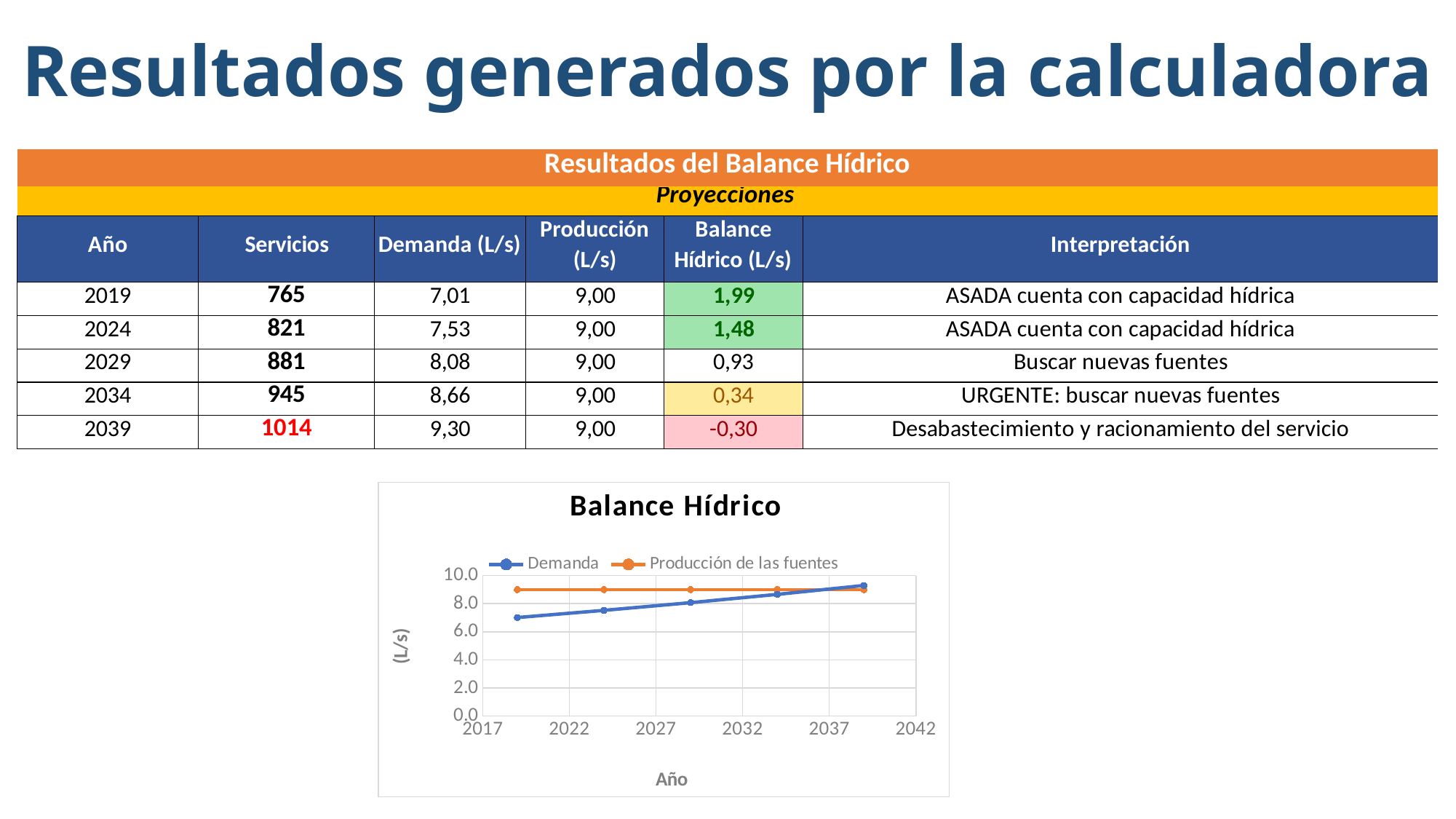
Does the Producción de las fuentes series rise, fall or stay flat along the x axis in the Balance Hídrico chart? Stay flat Does the Demanda series rise or fall along the x axis in the Balance Hídrico chart? Rise In the Balance Hídrico chart, is the Producción de las fuentes value greater or less than 8.0? greater In the Balance Hídrico chart, is the second Demanda point (around 2024) greater or less than 8.0? less What kind of chart is shown on the slide? Line chart In the Balance Hídrico chart, at the first point on the left, which series is higher: Demanda or Producción de las fuentes? Producción de las fuentes What is the label of the y axis in the Balance Hídrico chart? (L/s) In the Balance Hídrico chart, is the first Demanda value greater or less than 6.0? greater How many data points does the Demanda series have in the Balance Hídrico chart? 5 How many series does the legend of the Balance Hídrico chart list? 2 What is the title of the chart on the slide? Balance Hídrico